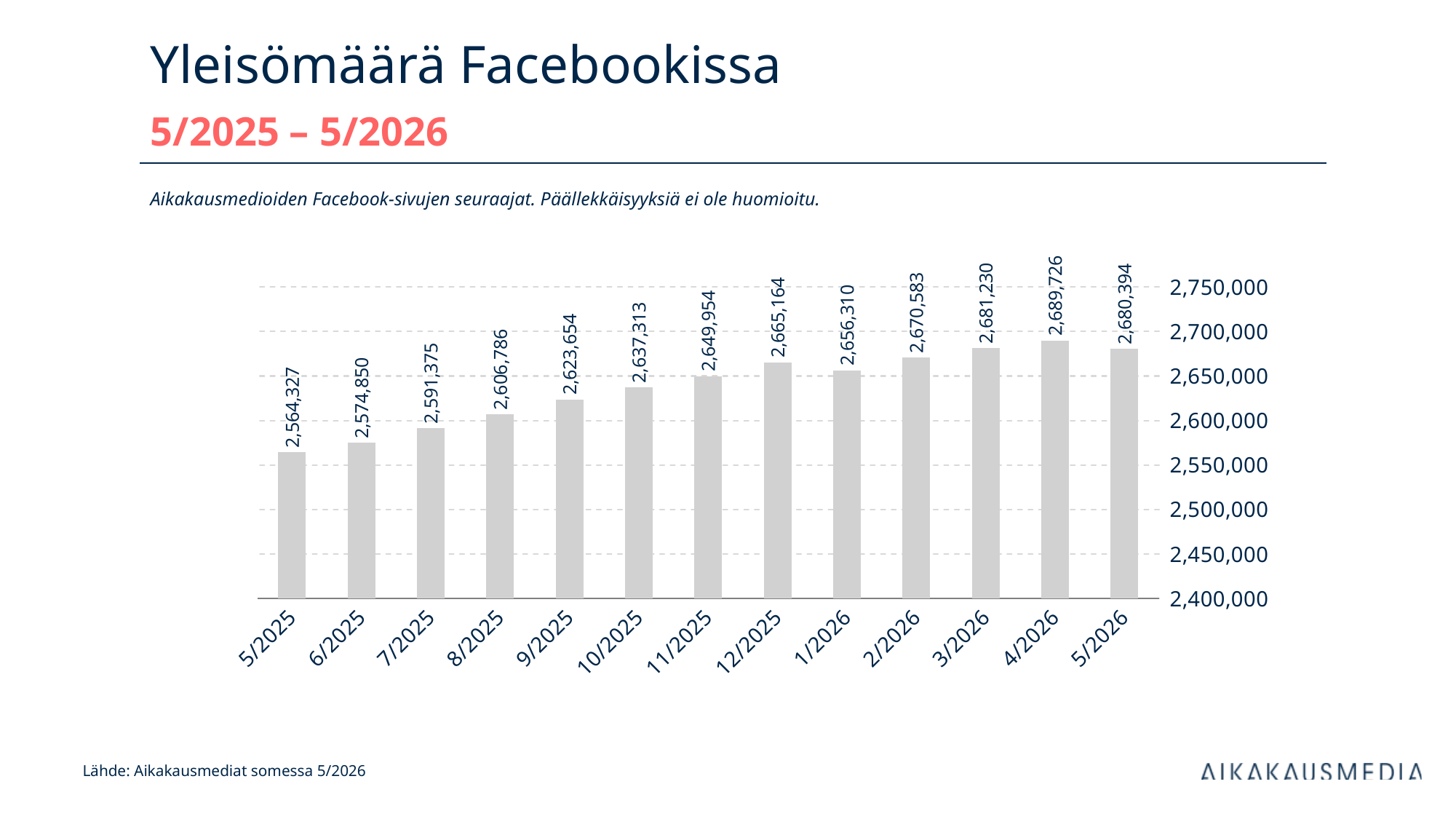
What is the value for 5/2025? 2,564,327 How many months are shown on the x axis? 13 Is the value for 9/2025 greater or less than 2,600,000? greater What is the value for 5/2026? 2,680,394 Which month has the highest value? 4/2026 Which month has the lowest value? 5/2025 What is the difference between the values for 5/2026 and 5/2025? 116,067 What is the value for 12/2025? 2,665,164 Which is larger, the value for 12/2025 or the value for 1/2026? 12/2025 What is the difference between the values for 4/2026 and 3/2026? 8,496 What type of chart is shown on the slide? bar chart What is the title of the chart on the slide? Yleisömäärä Facebookissa